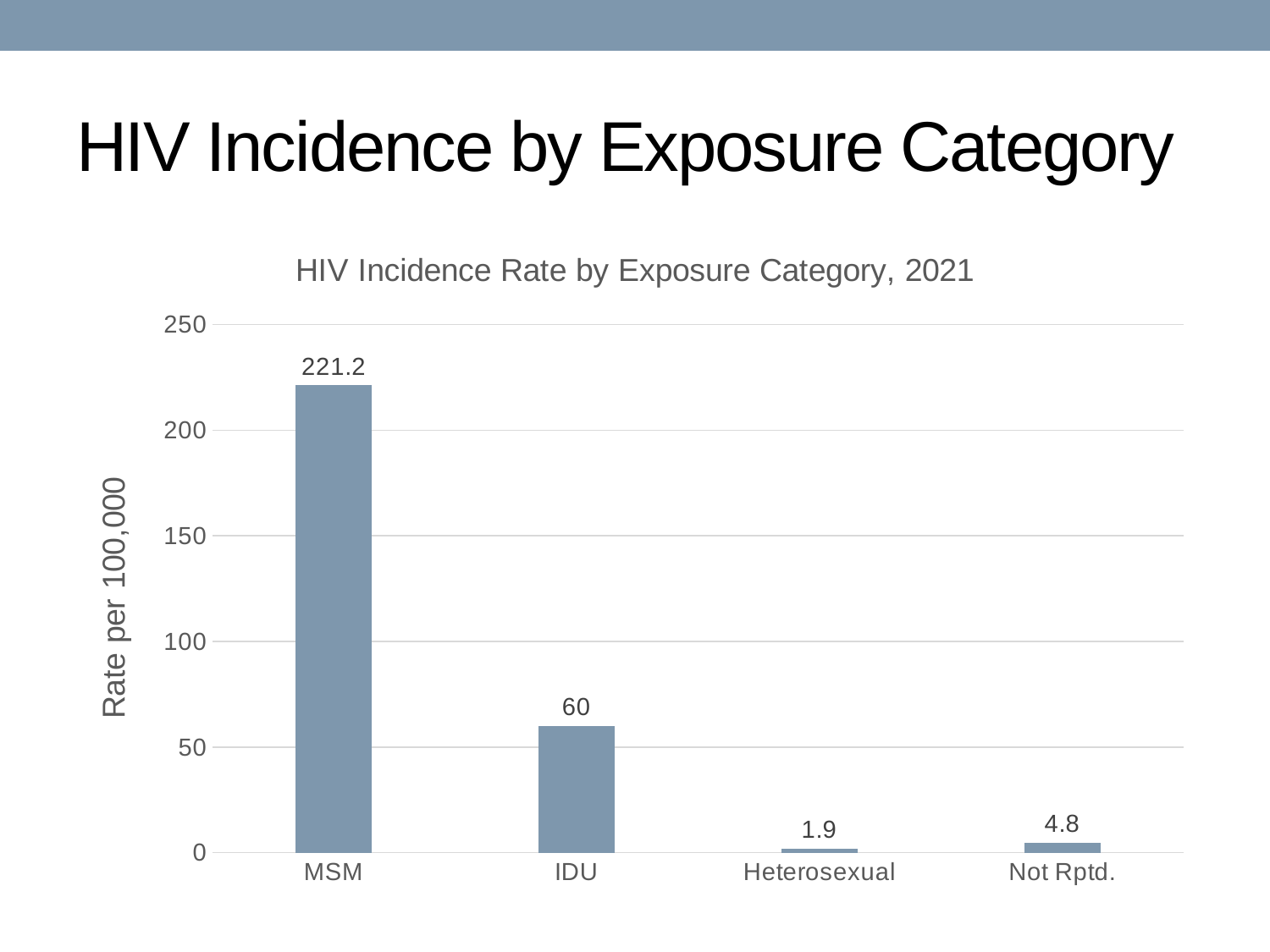
What is the HIV incidence rate per 100,000 for the Heterosexual category? 1.9 Which exposure category has the highest HIV incidence rate? MSM What is the label on the vertical axis of the chart? Rate per 100,000 Is the HIV incidence rate for MSM greater or less than 200? greater What is the HIV incidence rate per 100,000 for MSM? 221.2 Which has a higher HIV incidence rate, Not Rptd. or Heterosexual? Not Rptd. What is the difference between the HIV incidence rates for MSM and IDU? 161.2 What is the HIV incidence rate per 100,000 for Not Rptd.? 4.8 What type of chart is used to show HIV incidence rate by exposure category? Bar chart Which exposure category has the lowest HIV incidence rate? Heterosexual What is the HIV incidence rate per 100,000 for IDU? 60 How many exposure categories are shown in the chart? 4